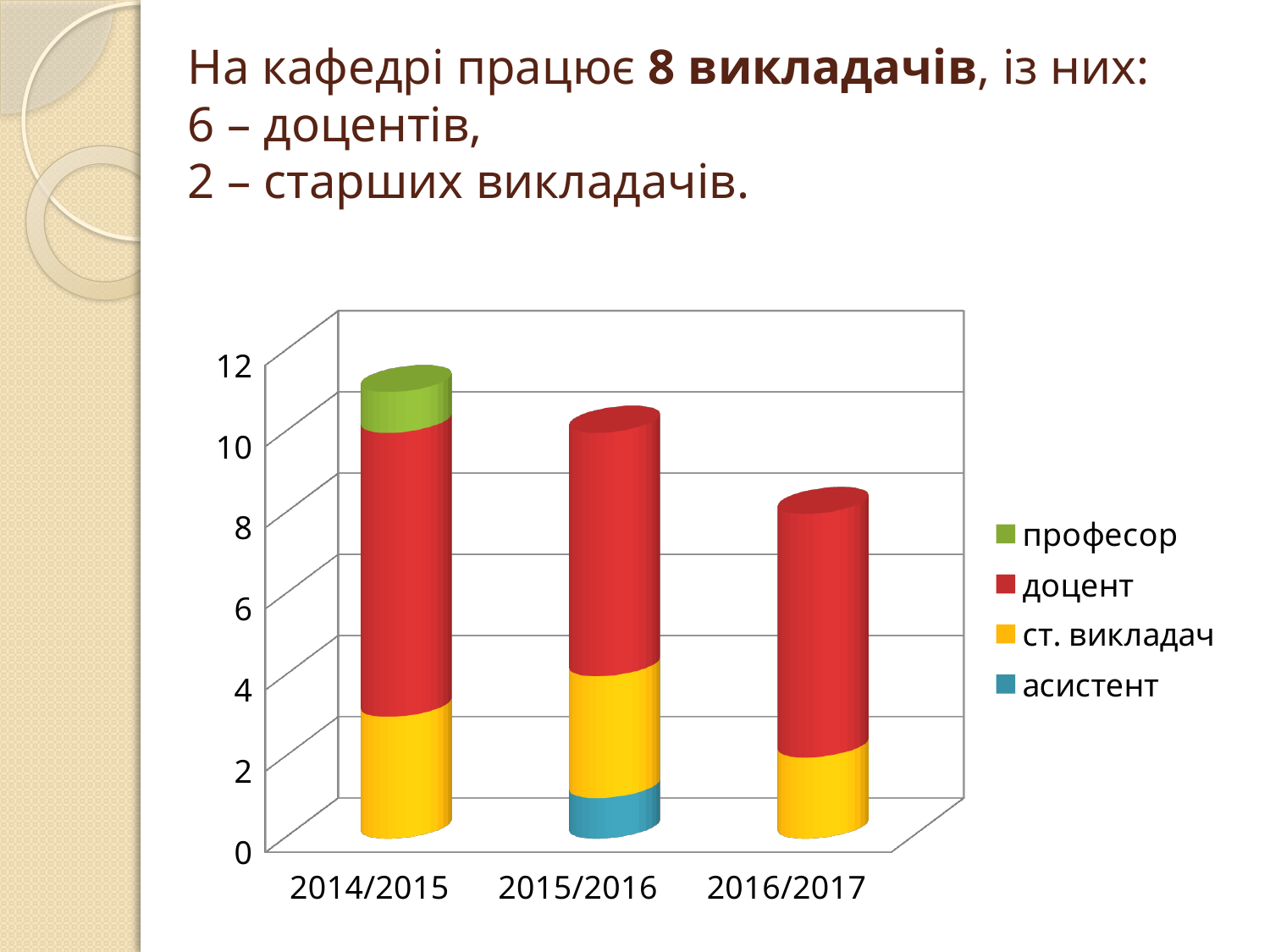
Is the total bar height for 2014/2015 greater or less than 10? greater Is the total bar height for 2016/2017 greater or less than 10? less How many series does the chart legend list? 4 Which academic year has the tallest stacked bar in the chart? 2014/2015 Which stacked bar is taller, 2014/2015 or 2016/2017? 2014/2015 How many academic years (categories) are shown on the x axis of the chart? 3 Which series is shown in green in the chart legend? професор Which academic year has the shortest stacked bar in the chart? 2016/2017 In which academic year does the bar include an асистент segment? 2015/2016 Do the total bar heights rise or fall from 2014/2015 to 2016/2017? fall Is the асистент segment in the 2015/2016 bar greater or less than 2? less What kind of chart is shown on the slide? stacked bar chart